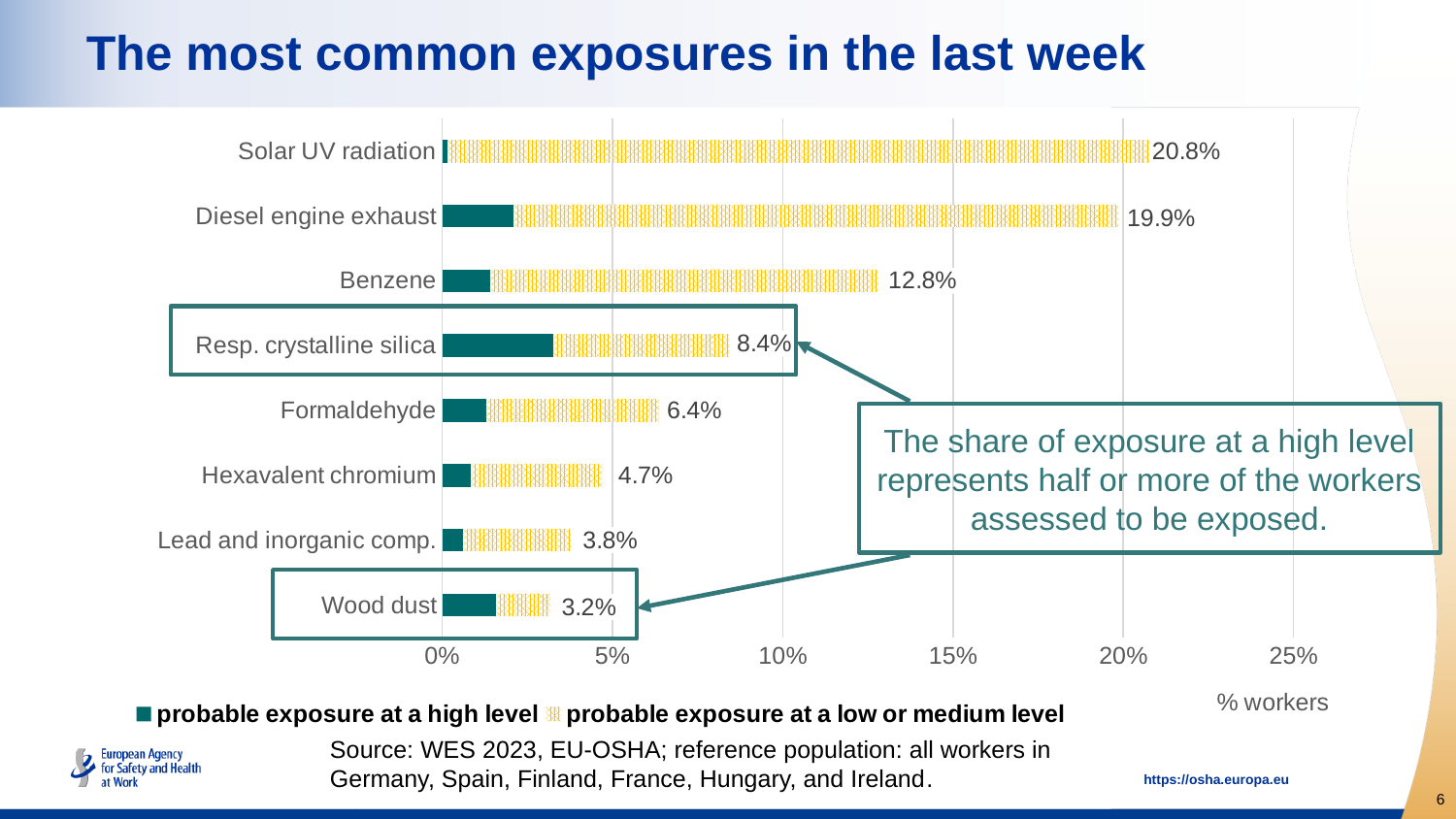
How many series does the legend list? 2 What is the total value shown for Wood dust? 3.2% Which has a larger total value, Benzene or Formaldehyde? Benzene What is the difference between the total values for Solar UV radiation and Diesel engine exhaust? 0.9% How many exposure categories are shown in the chart? 8 What is the total value shown for Resp. crystalline silica? 8.4% What is the total value shown for Solar UV radiation? 20.8% Which exposure has the highest total value? Solar UV radiation What is the total value shown for Hexavalent chromium? 4.7% Which exposure has the lowest total value? Wood dust Is the 'probable exposure at a high level' segment for Resp. crystalline silica greater or less than 5%? less What kind of chart is shown on the slide? Stacked bar chart